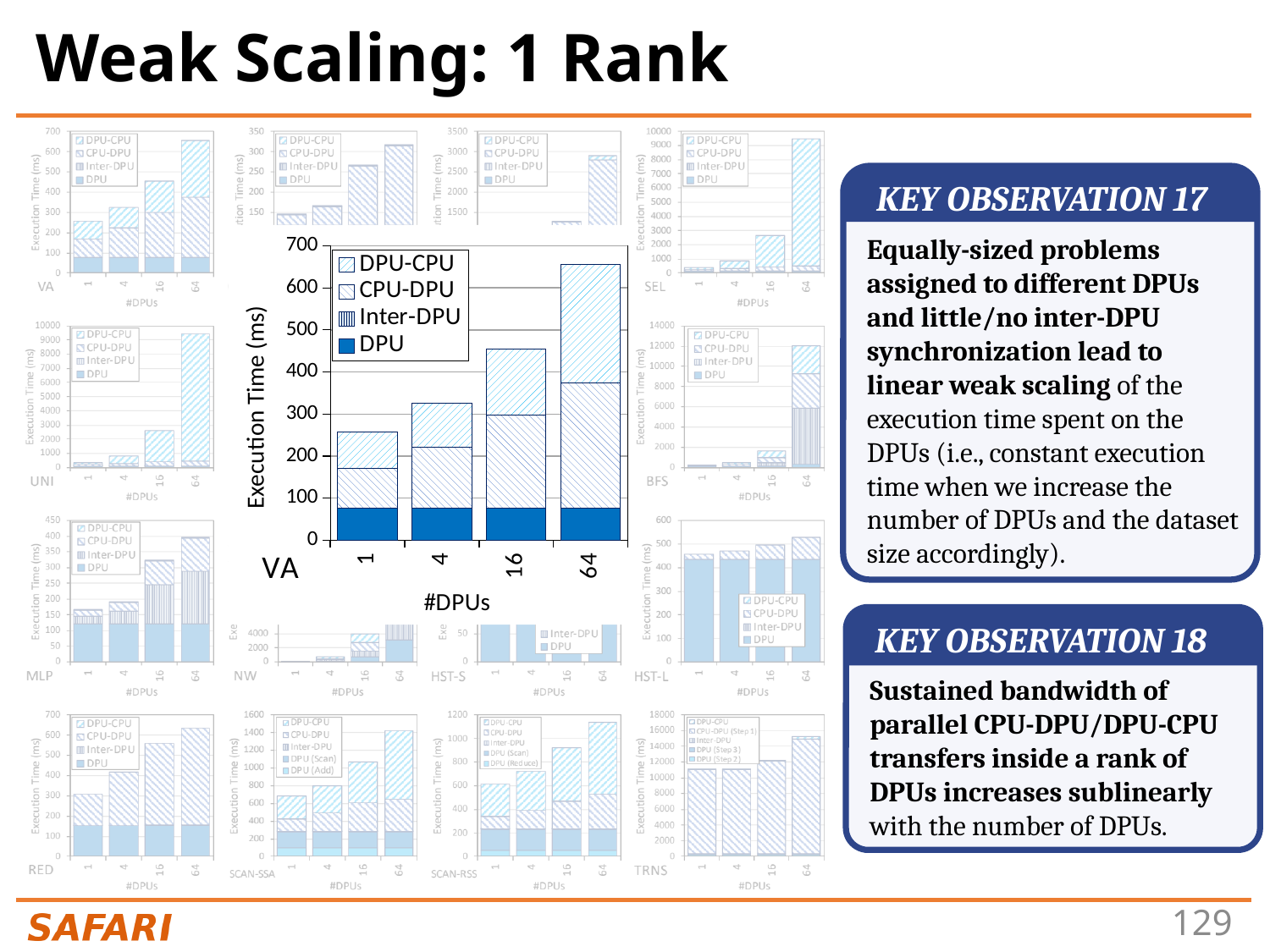
In the enlarged VA chart, which has the larger total execution time, 4 DPUs or 16 DPUs? 16 DPUs In the enlarged VA chart, is the total execution time for 16 DPUs greater or less than 400? greater In the enlarged VA chart, is the total execution time for 64 DPUs greater or less than 600? greater In the enlarged VA chart, which #DPUs category has the highest total execution time? 64 In the enlarged VA chart, does the total execution time rise or fall as #DPUs increases from 1 to 64? rise In the enlarged VA chart, what is the label of the y axis? Execution Time (ms) In the enlarged VA chart, what kind of chart is shown? bar chart In the enlarged VA chart, how many #DPUs categories are plotted on the x axis? 4 In the enlarged VA chart, is the DPU segment for 4 DPUs greater or less than 100? less In the enlarged VA chart, how many series does the legend list? 4 In the enlarged VA chart, which #DPUs category has the lowest total execution time? 1